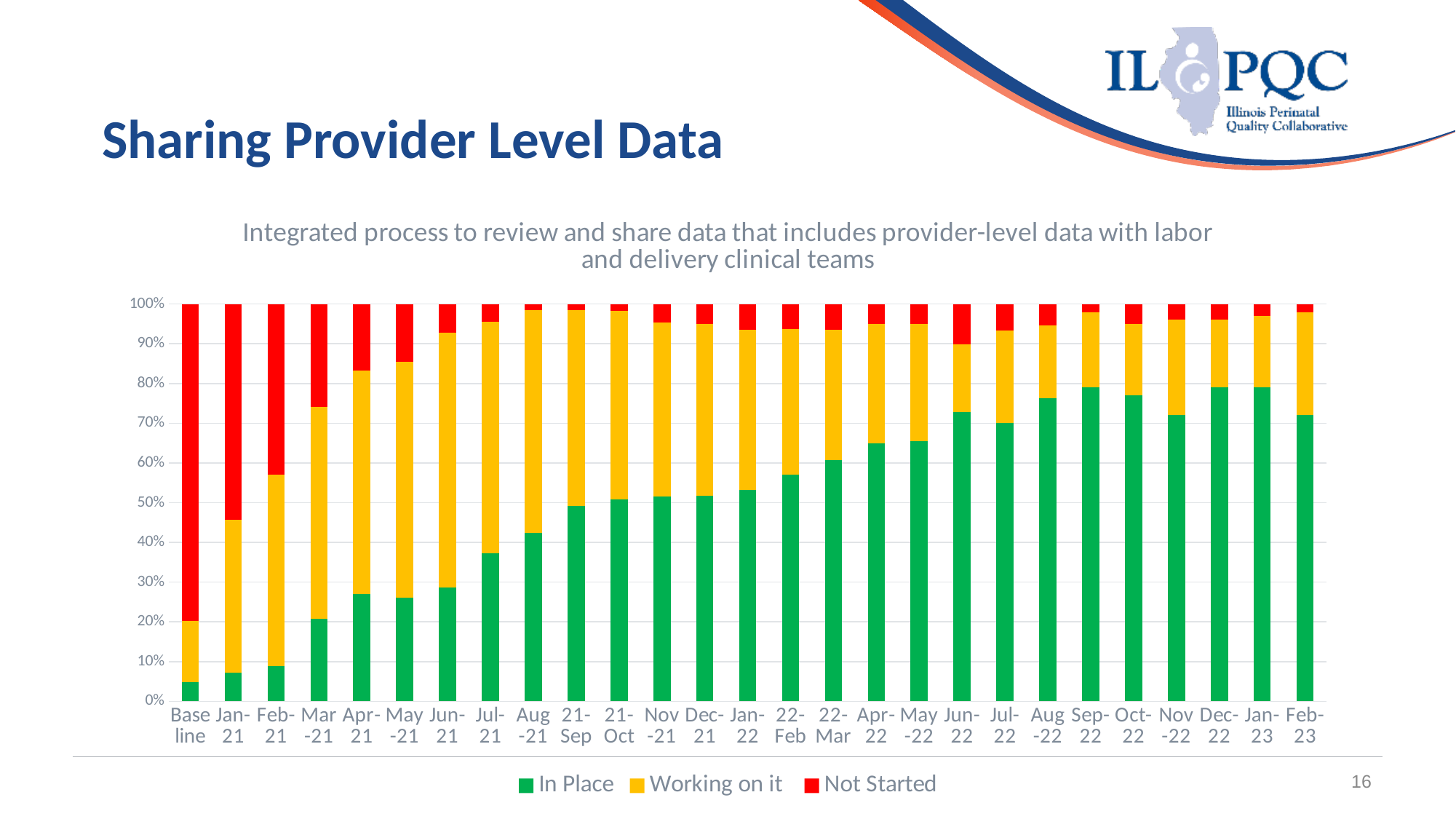
Which category has the highest 'Not Started' value? Baseline Is the 'In Place' value for Baseline greater or less than 10%? less Is the 'Not Started' value for Baseline greater or less than 70%? greater What kind of chart is shown on the slide? Stacked bar chart How many series does the legend list? 3 What colour represents the 'Working on it' series? Yellow Is the 'In Place' value for Aug-21 greater or less than 50%? less Does the 'In Place' share generally rise or fall from Baseline to Feb-23? Rise How many time-period categories are shown on the x axis? 27 Which category has the lowest 'In Place' value? Baseline Which is larger, the 'In Place' value for Baseline or for Feb-23? Feb-23